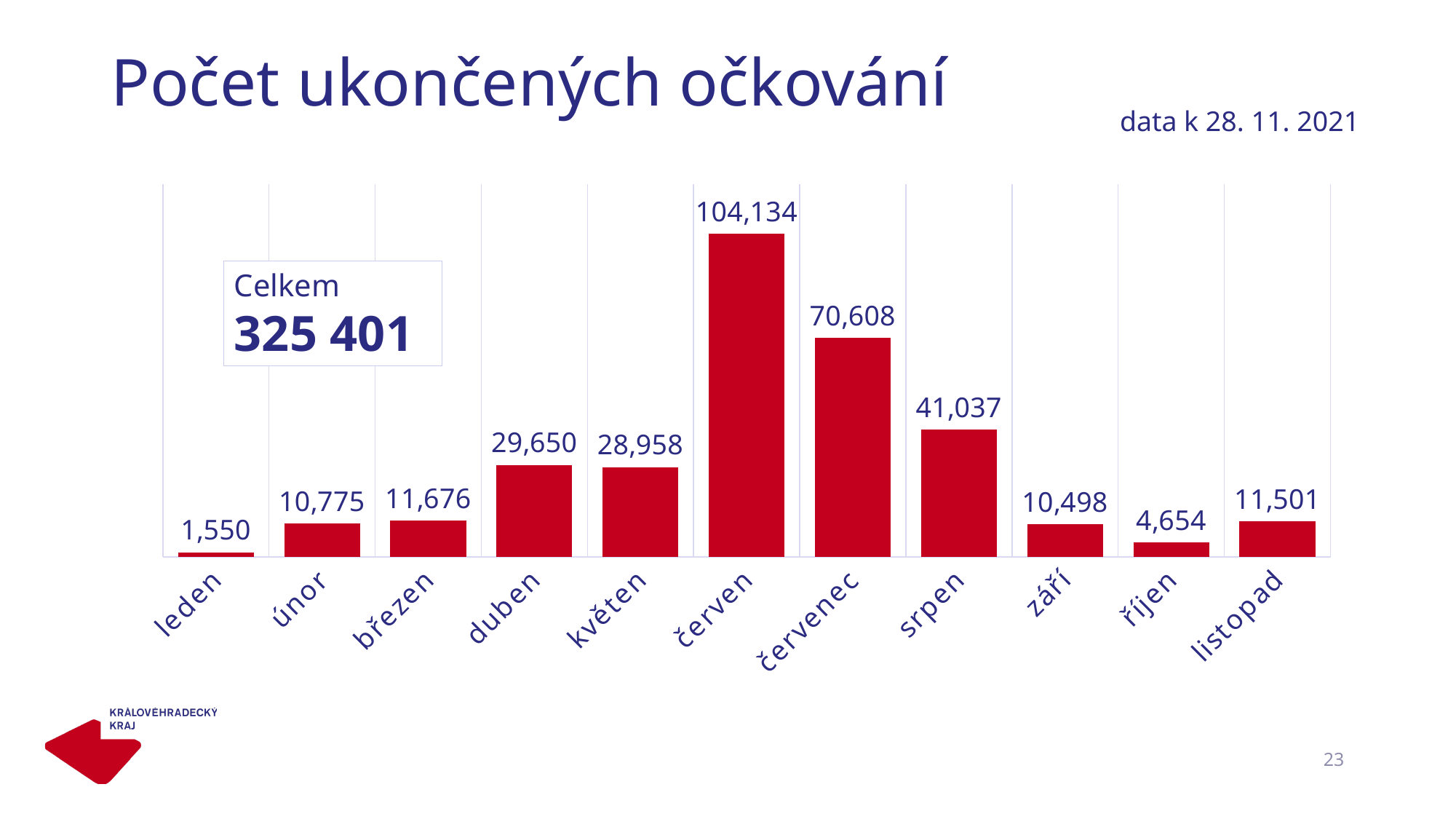
What kind of chart is shown on the slide? bar chart Which month has the highest value? červen How many months are shown on the x axis? 11 What is the value for listopad? 11,501 Do the values rise or fall from červen to říjen? fall Which month has the lowest value? leden Which is larger, the value for srpen or the value for květen? srpen What is the difference between the values for listopad and říjen? 6,847 What is the value for červen? 104,134 What total (Celkem) is shown in the box on the chart? 325 401 What is the value for leden? 1,550 What is the difference between the values for červen and červenec? 33,526